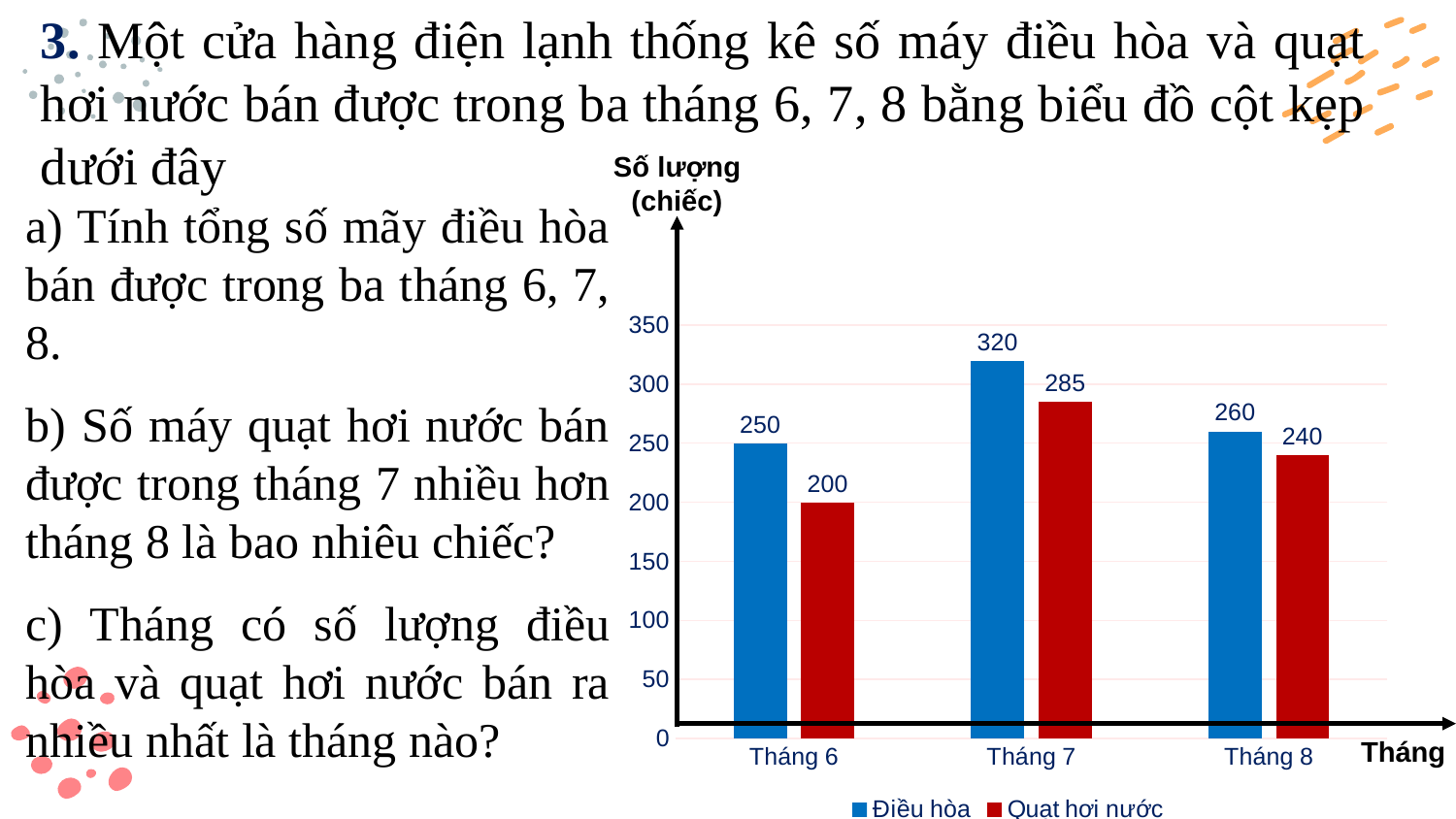
What is the label of the y axis? Số lượng (chiếc) What is the difference between the Quạt hơi nước values for Tháng 7 and Tháng 8? 45 Which month has the lowest value for Quạt hơi nước? Tháng 6 What is the value for Quạt hơi nước in Tháng 8? 240 How many months are shown on the x axis? 3 Which month has the highest value for Điều hòa? Tháng 7 What kind of chart is shown? bar chart What is the value for Quạt hơi nước in Tháng 6? 200 What is the value for Điều hòa in Tháng 7? 320 What is the total of Điều hòa across the three months? 830 Which is larger: Điều hòa in Tháng 6 or Điều hòa in Tháng 8? Điều hòa in Tháng 8 How many series does the legend list? 2